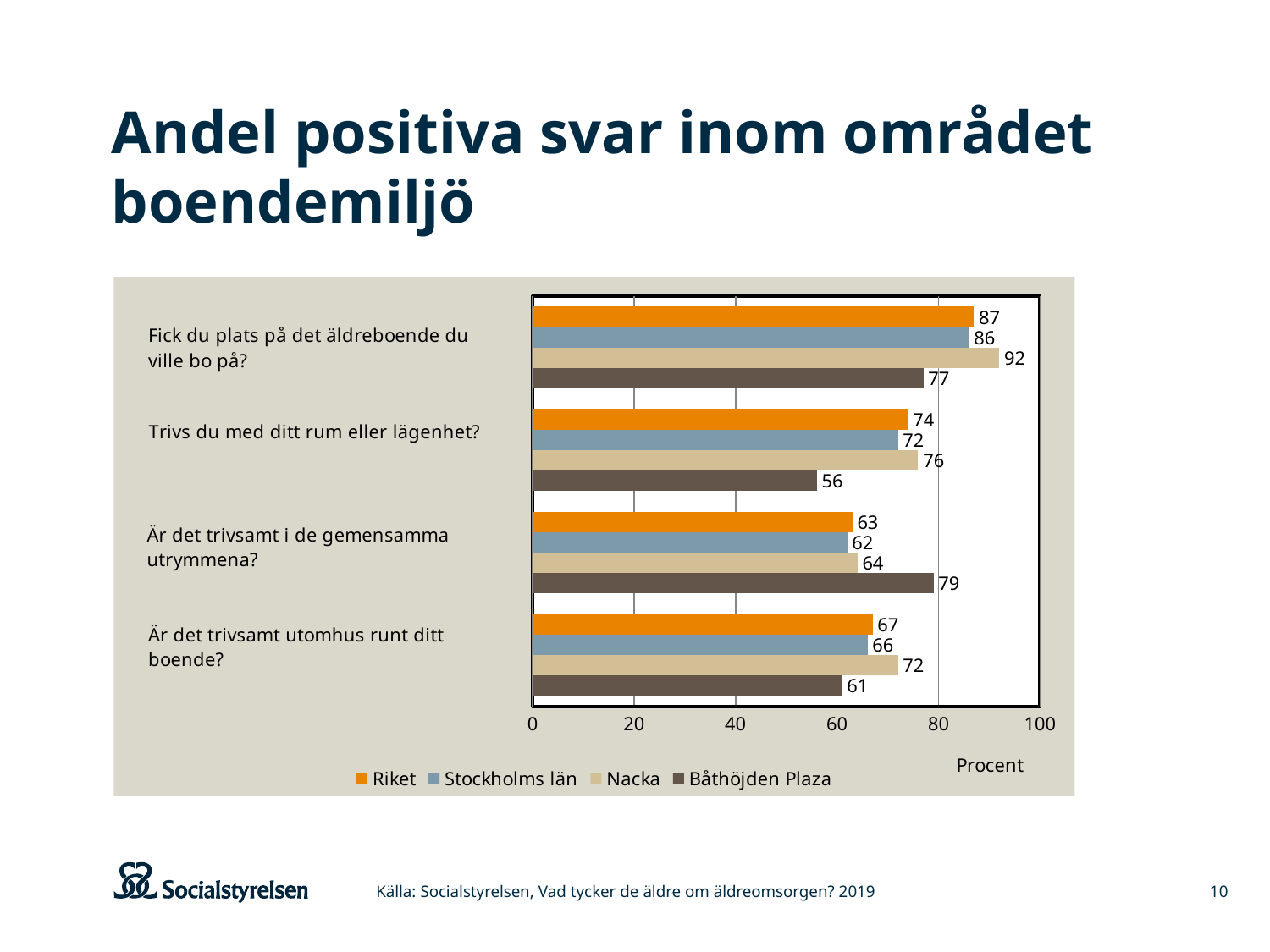
Which series has the highest value on "Är det trivsamt i de gemensamma utrymmena?"? Båthöjden Plaza Is the value for Båthöjden Plaza on "Är det trivsamt i de gemensamma utrymmena?" greater or less than 60? greater What is the value for Riket on "Är det trivsamt utomhus runt ditt boende?"? 67 How many questions (categories) are shown on the chart? 4 What unit is labelled on the horizontal axis? Procent Which is larger on "Är det trivsamt utomhus runt ditt boende?": Stockholms län or Nacka? Nacka What kind of chart is shown on the slide? Bar chart What is the value for Nacka on "Fick du plats på det äldreboende du ville bo på?"? 92 What is the value for Båthöjden Plaza on "Trivs du med ditt rum eller lägenhet?"? 56 Which series has the lowest value on "Fick du plats på det äldreboende du ville bo på?"? Båthöjden Plaza What is the difference between Nacka and Båthöjden Plaza on "Trivs du med ditt rum eller lägenhet?"? 20 How many series does the legend list? 4